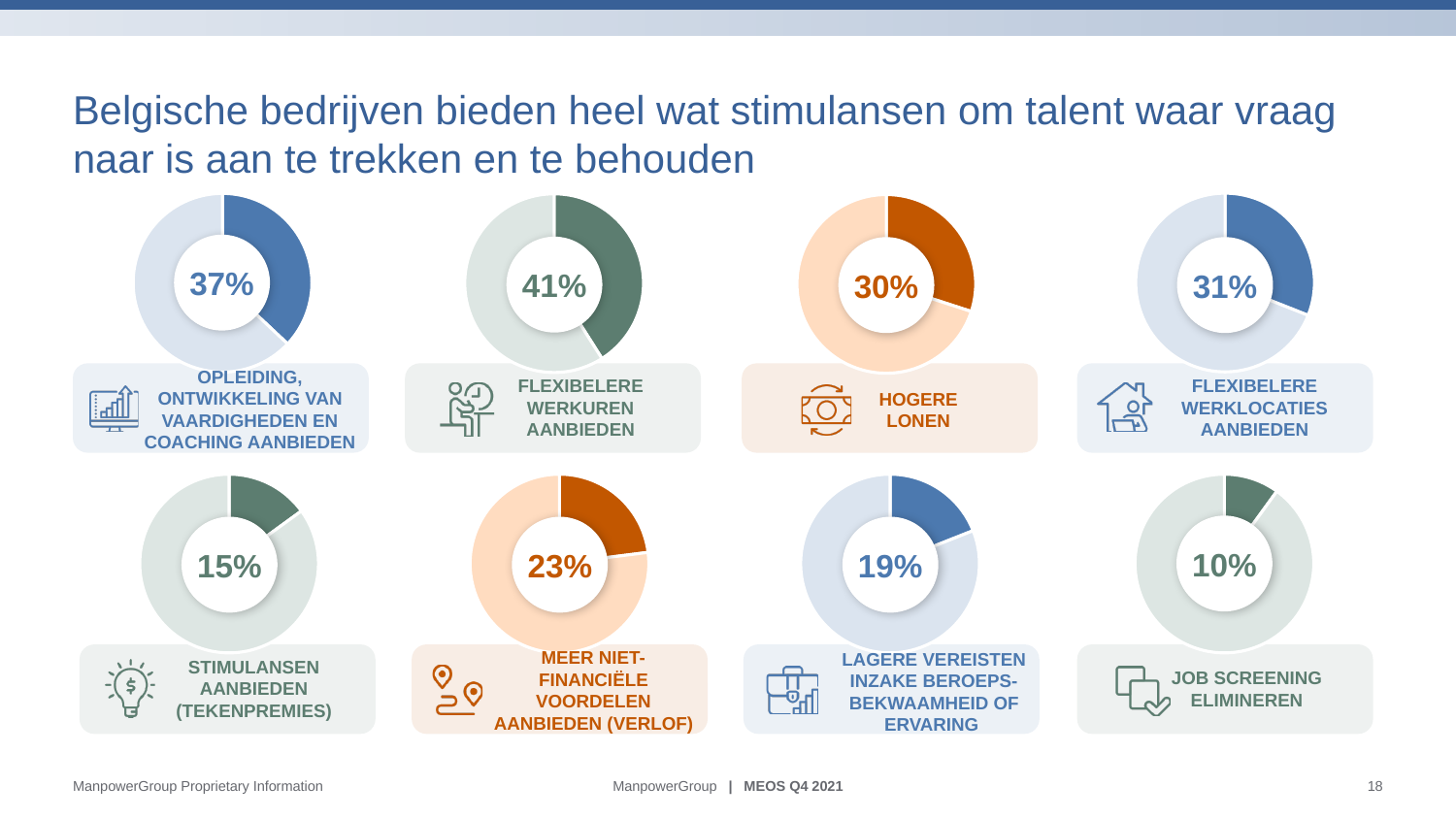
What is the difference between the percentage for 'Flexibelere werkuren aanbieden' and the percentage for 'Hogere lonen'? 11% What percentage is shown in the donut chart labelled 'Hogere lonen'? 30% Which of the eight donut charts on the slide shows the highest percentage? Flexibelere werkuren aanbieden (41%) Which of the eight donut charts on the slide shows the lowest percentage? Job screening elimineren (10%) How many donut charts are shown on the slide? 8 What is the difference between the percentage for 'Opleiding, ontwikkeling van vaardigheden en coaching aanbieden' and the percentage for 'Job screening elimineren'? 27% What percentage is shown in the donut chart labelled 'Flexibelere werkuren aanbieden'? 41% Which is larger: the percentage for 'Flexibelere werklocaties aanbieden' or the percentage for 'Meer niet-financiële voordelen aanbieden (verlof)'? Flexibelere werklocaties aanbieden (31%) What percentage is shown in the donut chart labelled 'Stimulansen aanbieden (tekenpremies)'? 15% What percentage is shown in the donut chart labelled 'Job screening elimineren'? 10% What kind of chart is used to display each percentage on the slide? Donut (pie) chart What percentage is shown in the donut chart labelled 'Lagere vereisten inzake beroepsbekwaamheid of ervaring'? 19%